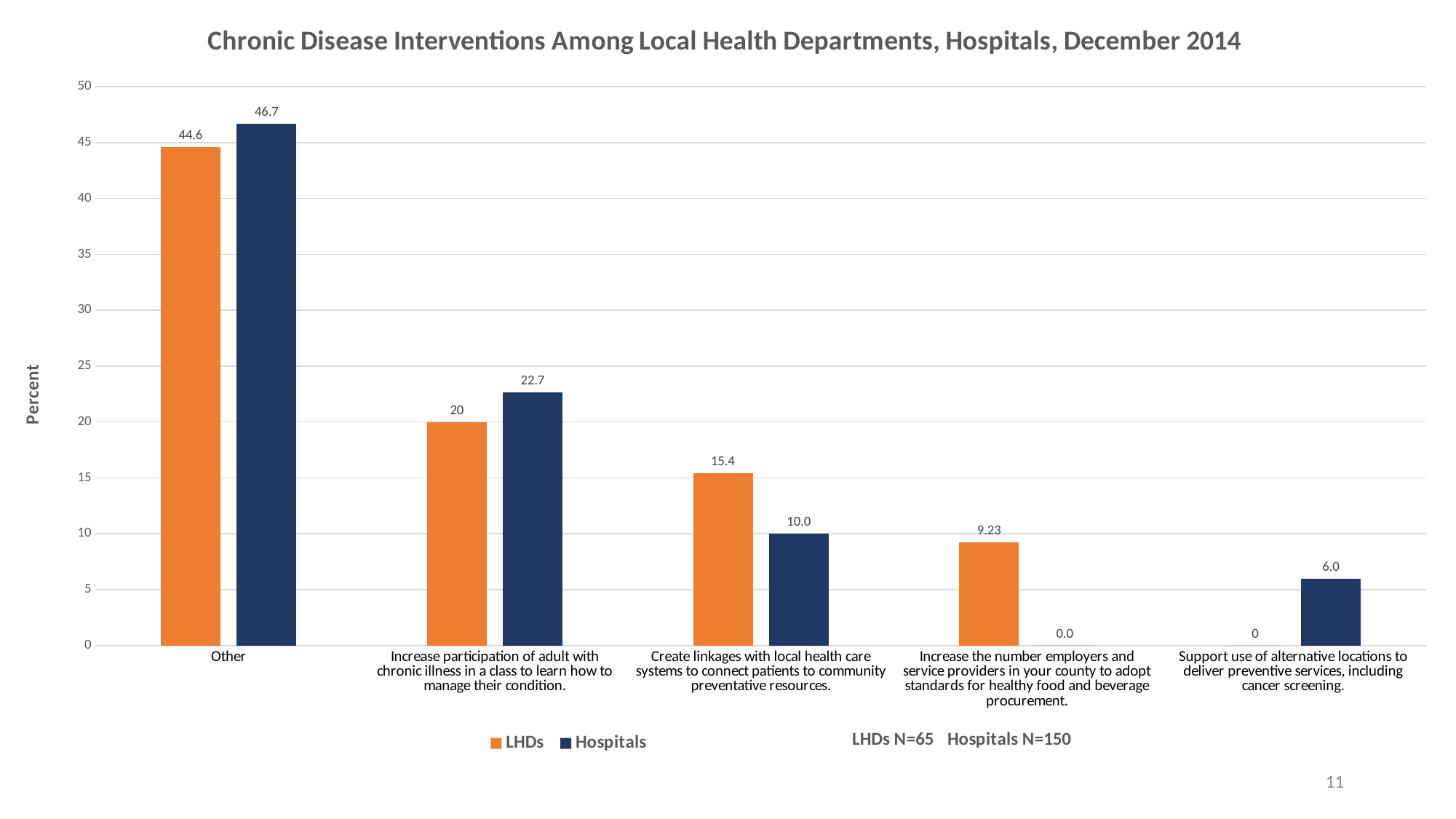
For "Create linkages with local health care systems to connect patients to community preventative resources.", which series has the larger value, LHDs or Hospitals? LHDs How many categories are shown on the x axis? 5 What is the Hospitals value for "Create linkages with local health care systems to connect patients to community preventative resources."? 10.0 How many series does the legend list? 2 What is the Hospitals value for "Support use of alternative locations to deliver preventive services, including cancer screening."? 6.0 What is the title of the chart? Chronic Disease Interventions Among Local Health Departments, Hospitals, December 2014 Which category has the lowest LHDs value? Support use of alternative locations to deliver preventive services, including cancer screening. Which category has the highest Hospitals value? Other What is the LHDs value for the "Other" category? 44.6 What is the difference between the Hospitals and LHDs values for the "Other" category? 2.1 What kind of chart is shown on the slide? Bar chart What is the LHDs value for "Increase the number employers and service providers in your county to adopt standards for healthy food and beverage procurement."? 9.23